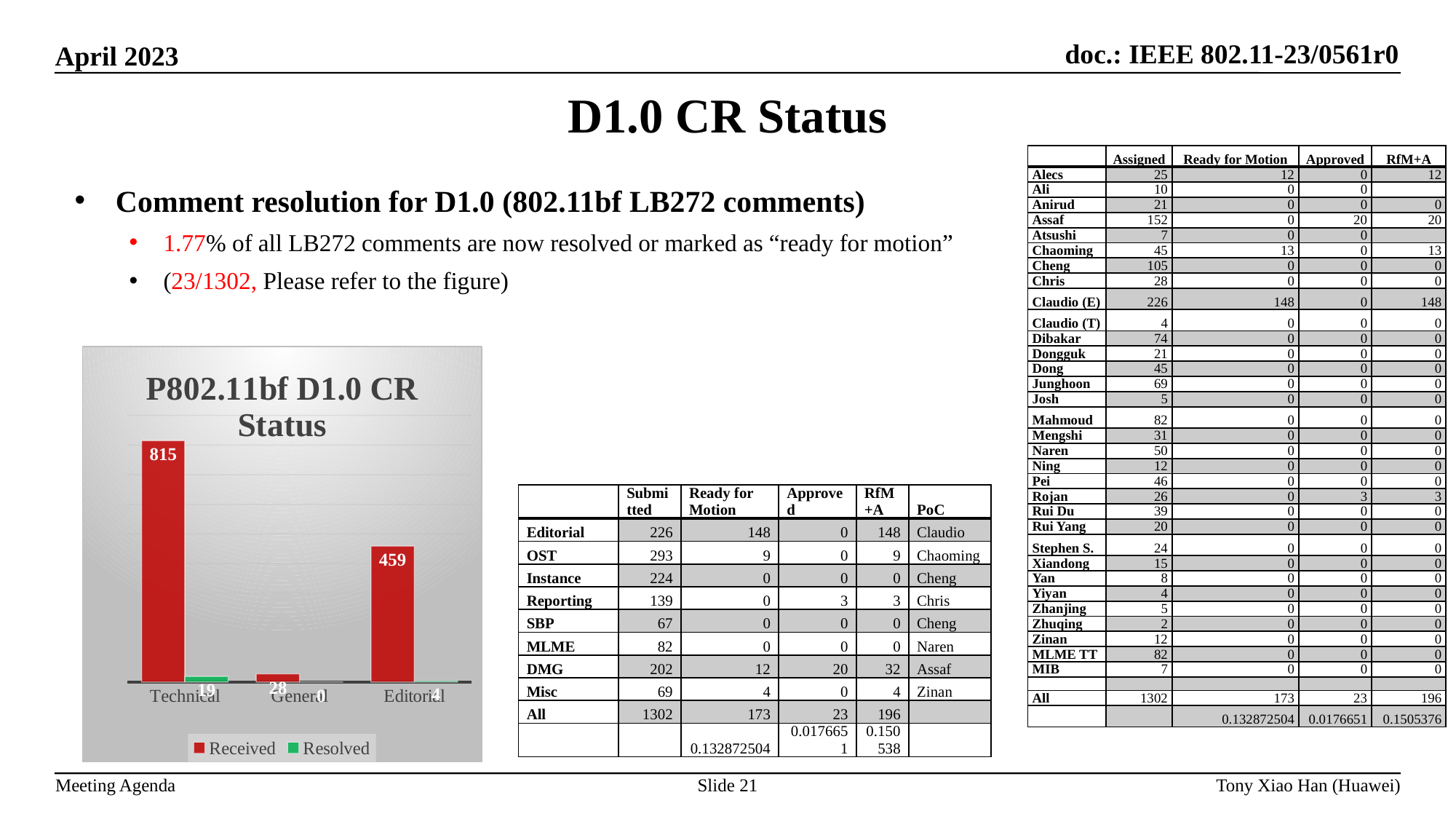
What is the difference between the Received values for Technical and Editorial? 356 What is the chart's title? P802.11bf D1.0 CR Status How many series does the legend list? 2 What is the Received value for General? 28 Which series are listed in the legend? Received and Resolved Which category has the highest Received value? Technical How many categories are shown on the x axis? 3 What is the Received value for Editorial? 459 What is the Resolved value for Technical? 19 Which category has the lowest Received value? General What is the Received value for Technical? 815 What kind of chart is shown on the slide? bar chart